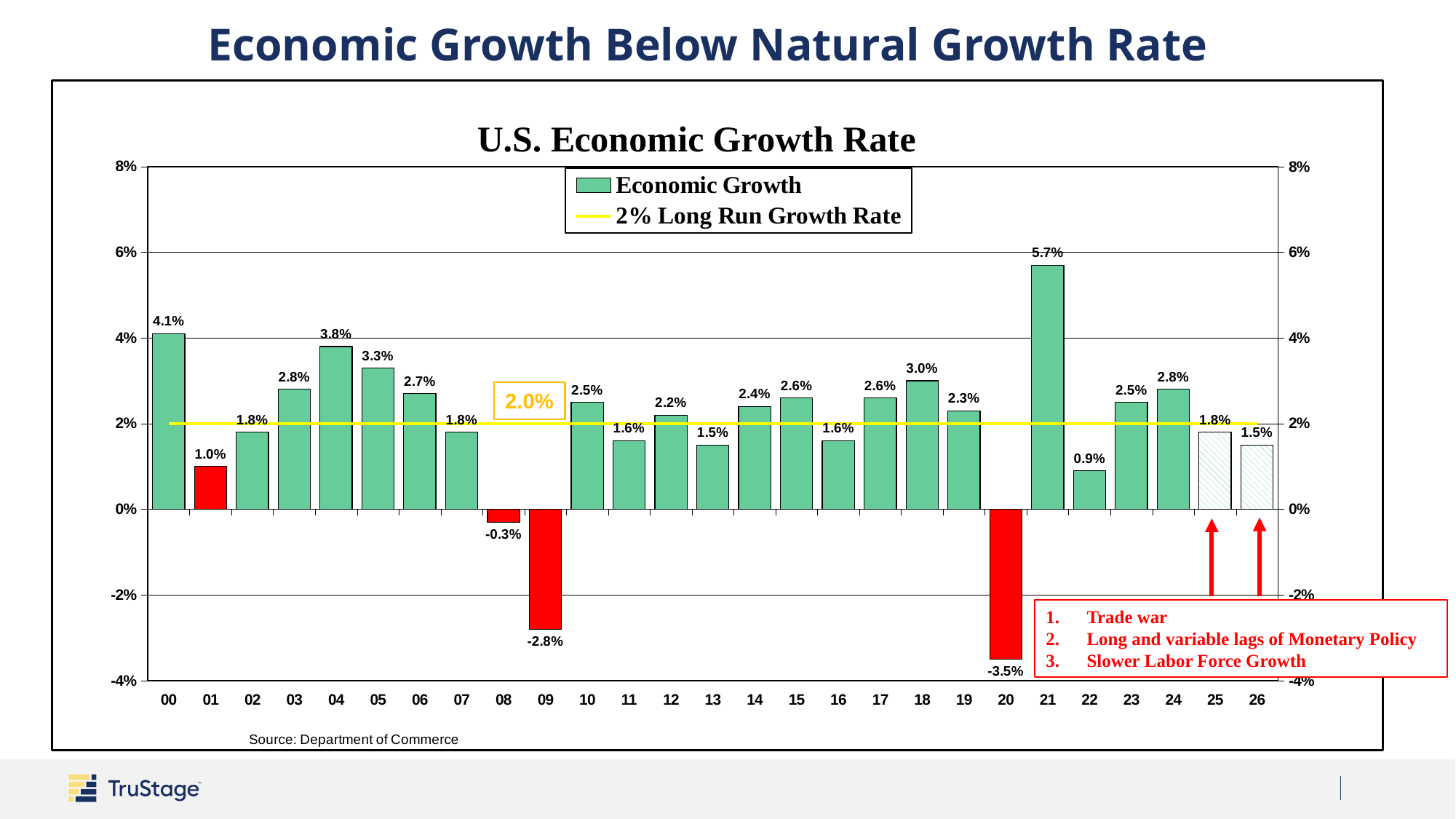
What is the difference between the growth rate in 21 and the growth rate in 22? 4.8% What is the U.S. economic growth rate shown for 21? 5.7% Which year has a higher growth rate, 04 or 05? 04 Which year has the lowest economic growth rate? 20 What is the economic growth rate shown for 26? 1.5% How many years are shown on the x axis? 27 What kind of chart is used to show the economic growth rate? bar chart What is the economic growth rate shown for 09? -2.8% How many entries does the legend list? 2 Which year has the highest economic growth rate? 21 What value does the yellow horizontal line represent? 2% Long Run Growth Rate Is the growth rate for 00 greater or less than 4%? greater